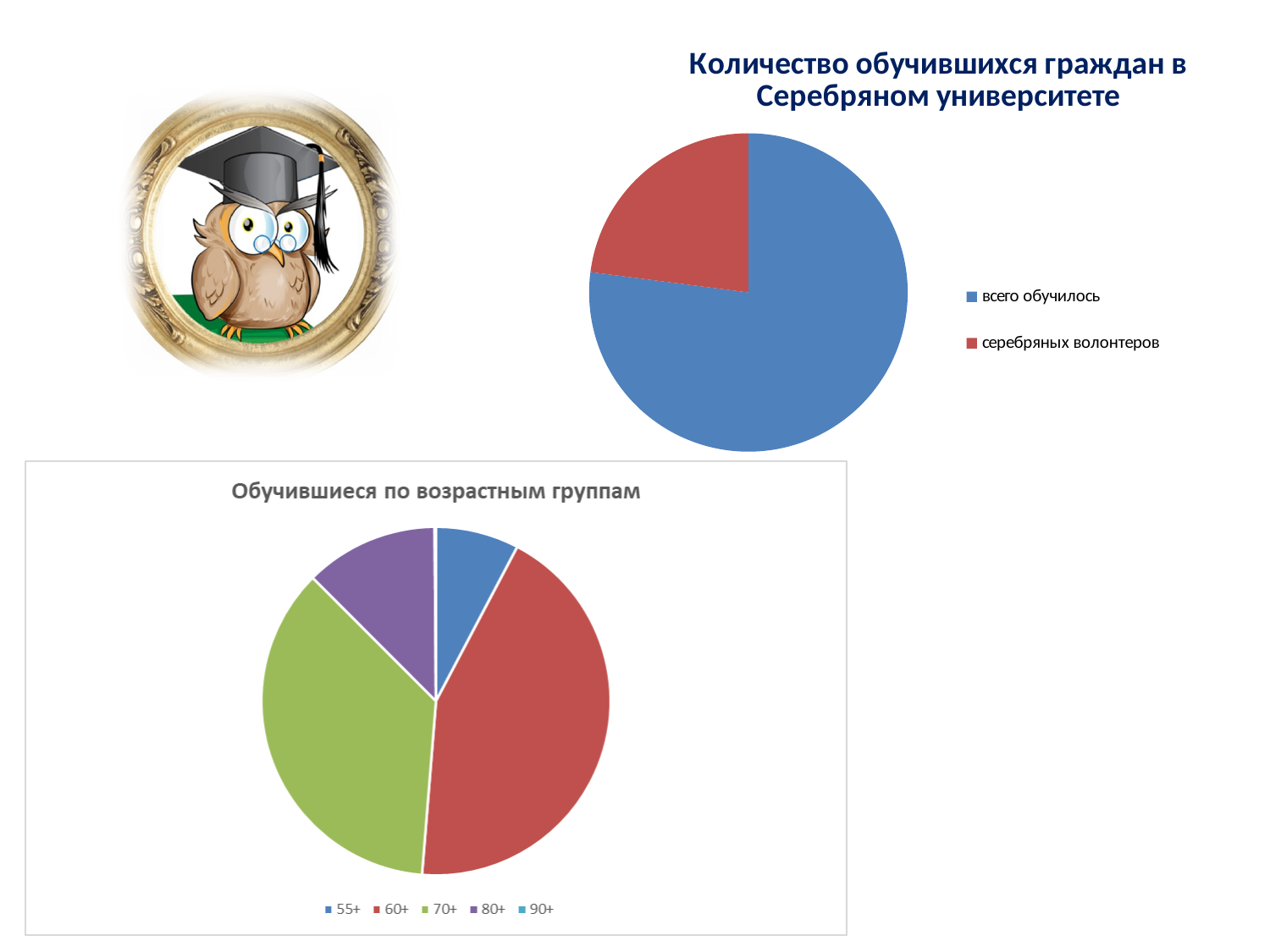
In the chart titled "Количество обучившихся граждан в Серебряном университете", what colour is the slice for "серебряных волонтеров"? red In the chart titled "Обучившиеся по возрастным группам", which slice is larger, 60+ or 70+? 60+ In the chart titled "Обучившиеся по возрастным группам", which slice is larger, 55+ or 80+? 80+ In the chart titled "Количество обучившихся граждан в Серебряном университете", how many entries does the legend list? 2 In the chart titled "Обучившиеся по возрастным группам", how many age groups does the legend list? 5 In the chart titled "Обучившиеся по возрастным группам", which slice is larger, 70+ or 80+? 70+ What kind of chart is the chart titled "Количество обучившихся граждан в Серебряном университете"? pie chart In the chart titled "Количество обучившихся граждан в Серебряном университете", which category has the largest slice? всего обучилось In the chart titled "Количество обучившихся граждан в Серебряном университете", which category has the smallest slice? серебряных волонтеров What is the title of the pie chart at the bottom of the slide? Обучившиеся по возрастным группам In the chart titled "Обучившиеся по возрастным группам", which age group has the largest slice? 60+ What kind of chart is the chart titled "Обучившиеся по возрастным группам"? pie chart